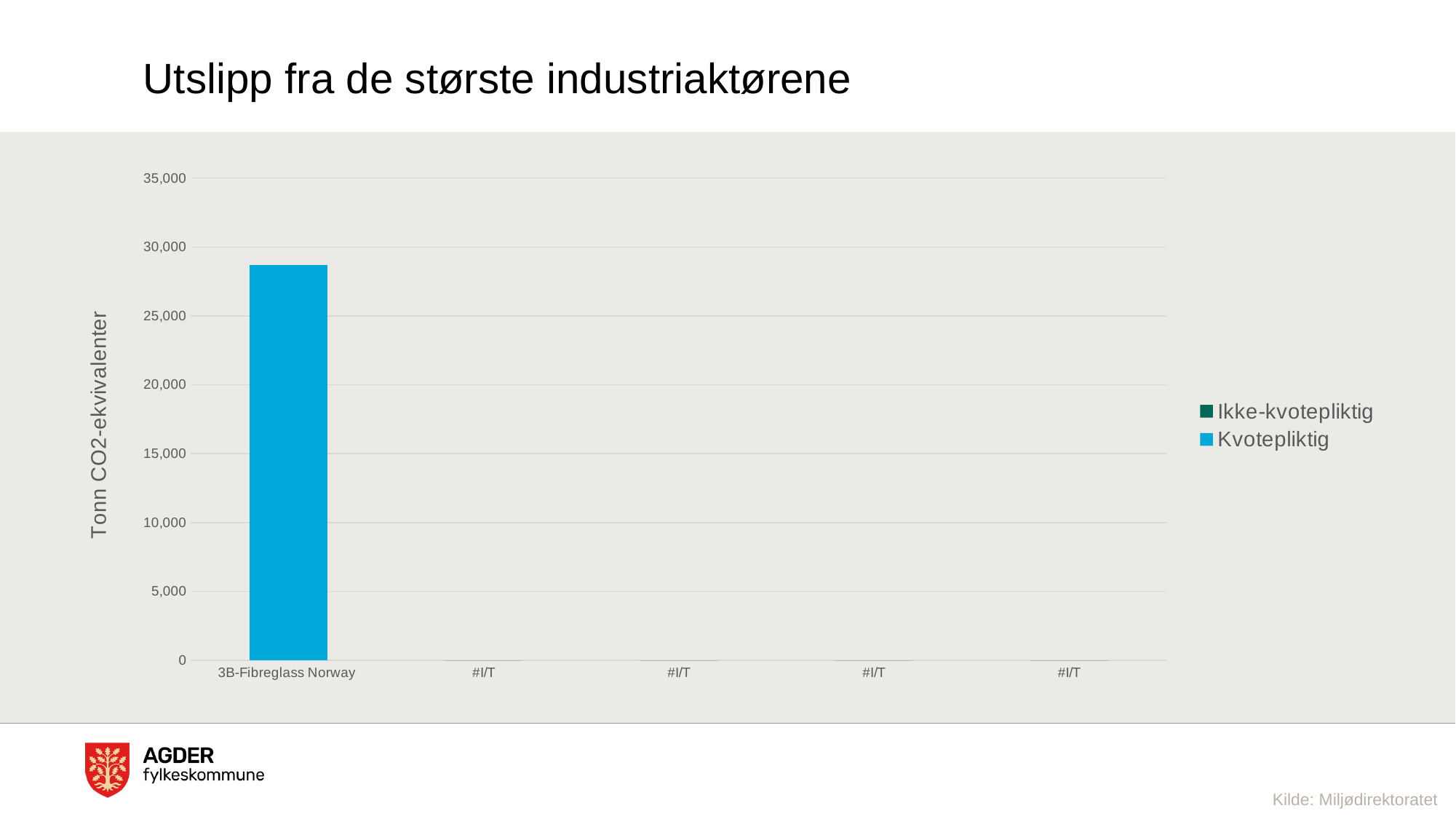
What kind of chart is shown on the slide? bar chart Which series does the bar for 3B-Fibreglass Norway belong to, according to the legend colours? Kvotepliktig How many series does the legend list? 2 Which category has the highest value in the chart? 3B-Fibreglass Norway How many categories are shown along the x axis of the chart? 5 Is the value for 3B-Fibreglass Norway greater or less than 30,000? less What is the label on the vertical axis of the chart? Tonn CO2-ekvivalenter Is the value for 3B-Fibreglass Norway greater or less than 20,000? greater What is the highest value shown on the vertical axis of the chart? 35,000 Is the value for 3B-Fibreglass Norway greater or less than 25,000? greater What is the title of the slide containing the chart? Utslipp fra de største industriaktørene